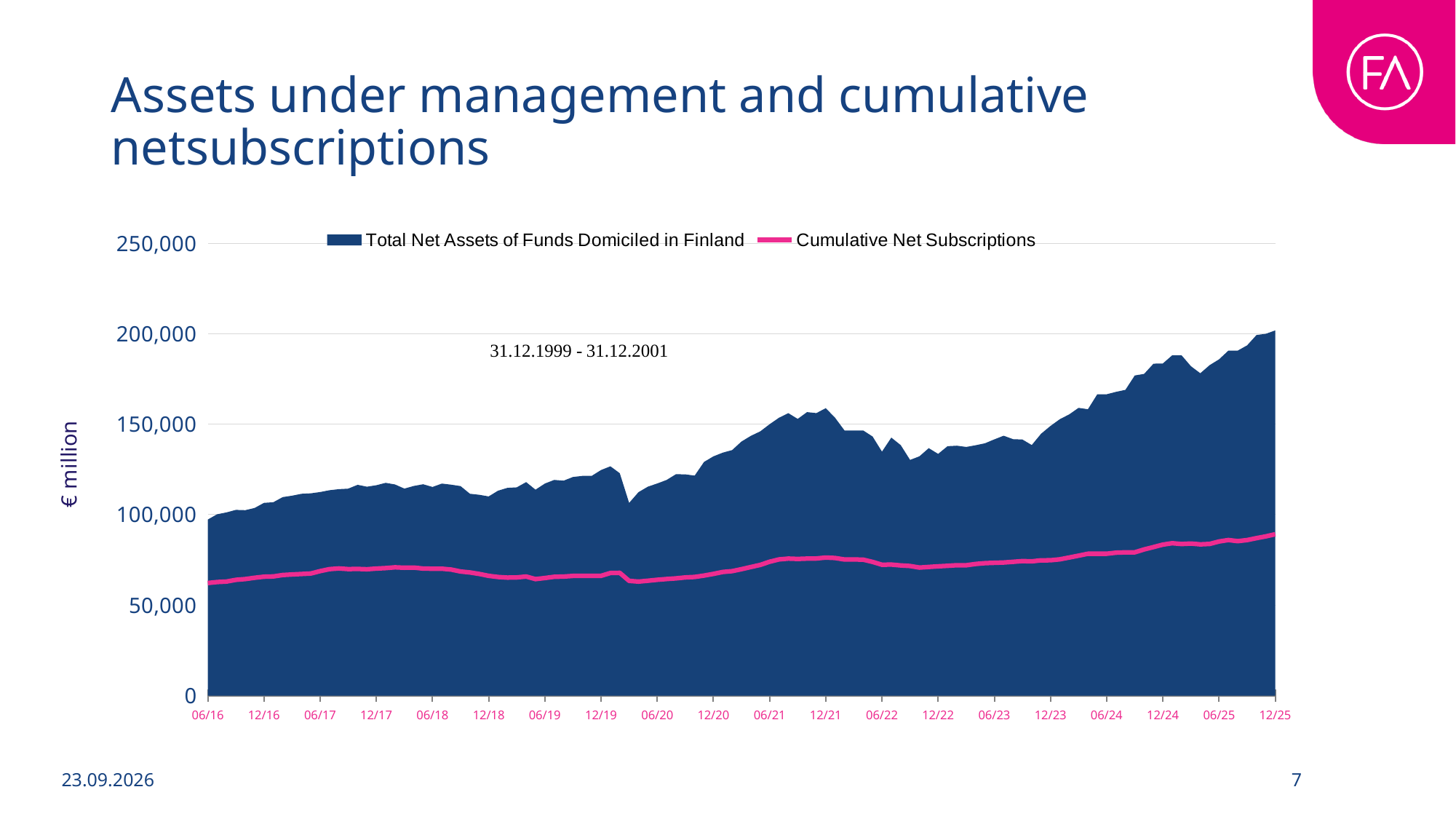
At which x-axis label does Total Net Assets of Funds Domiciled in Finland reach its highest value? 12/25 How many date labels are shown on the x axis? 20 Is the value of Total Net Assets of Funds Domiciled in Finland at 12/25 greater or less than 150,000? greater At 12/25, which series has the higher value: Total Net Assets of Funds Domiciled in Finland or Cumulative Net Subscriptions? Total Net Assets of Funds Domiciled in Finland Is the value of Total Net Assets of Funds Domiciled in Finland at 06/16 greater or less than 50,000? greater Overall, do the values of Cumulative Net Subscriptions rise or fall from 06/16 to 12/25? rise What unit is shown on the vertical axis label? € million What are the two series named in the legend? Total Net Assets of Funds Domiciled in Finland; Cumulative Net Subscriptions What kind of chart is shown on the slide? Area chart with a line series Is the value of Cumulative Net Subscriptions at 06/16 greater or less than 100,000? less How many series does the legend list? 2